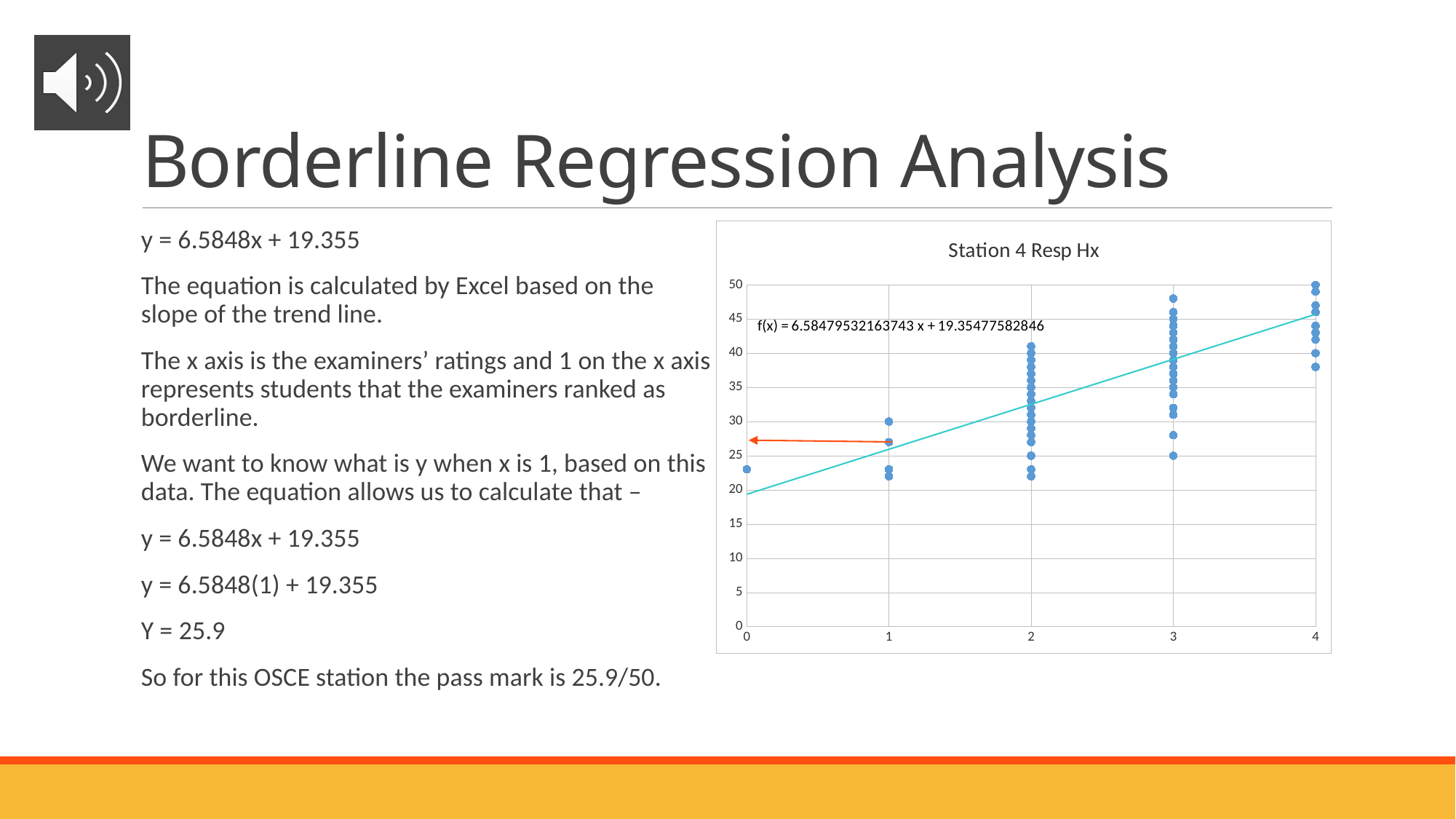
Is the data point at x = 0 greater or less than 25? less Does the trend line rise or fall as x increases from 0 to 4? rise How many distinct x values have data points plotted on the chart? 5 What trend line equation is printed on the chart? f(x) = 6.58479532163743 x + 19.35477582846 What kind of chart is shown on the slide? scatter chart Is the highest data point at x = 4 greater or less than 45? greater Is the highest data point at x = 1 greater or less than 35? less Which x value has the highest data points on the chart, 1 or 4? 4 What is the maximum value shown on the y axis? 50 What is the title of the chart? Station 4 Resp Hx